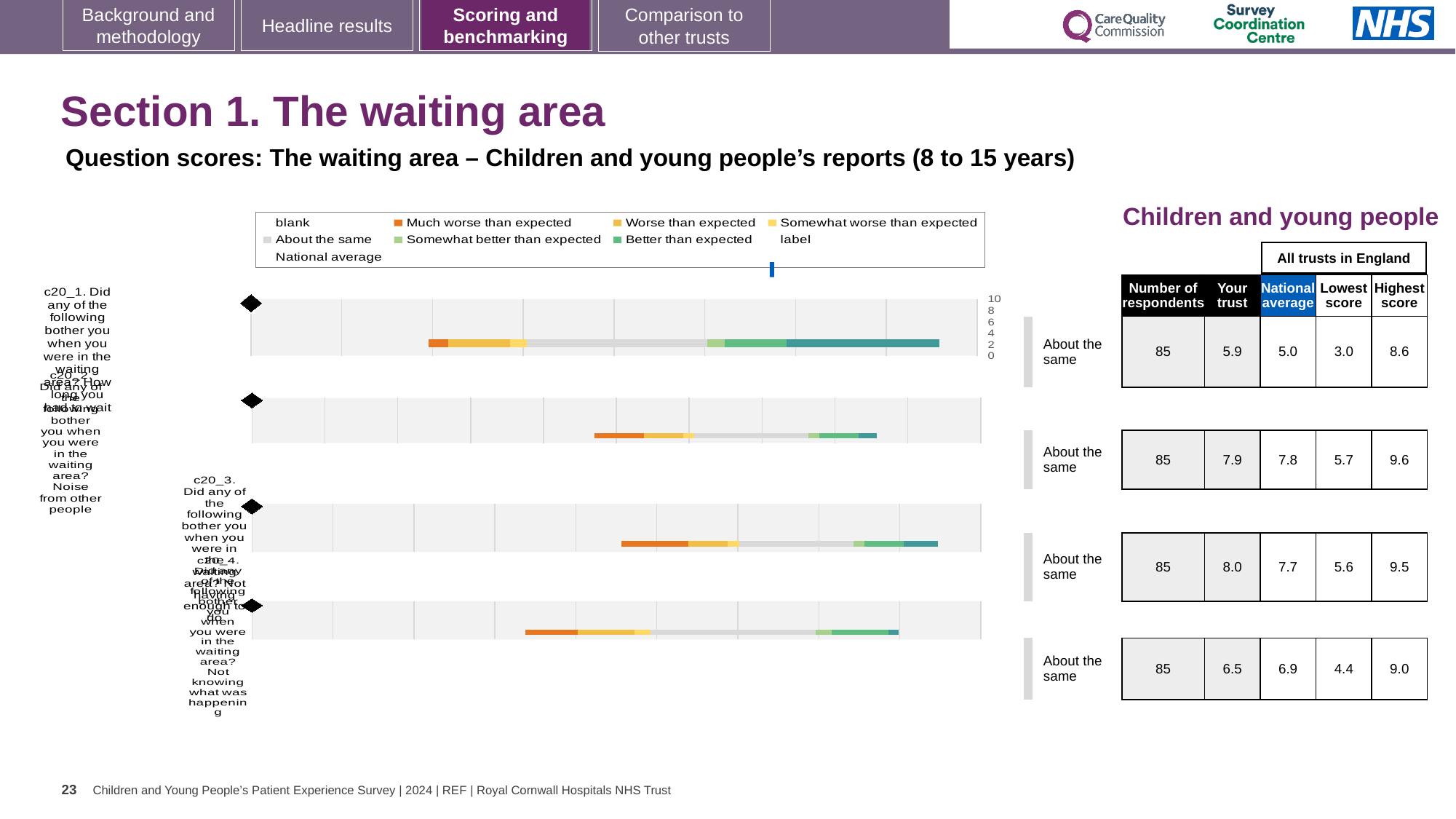
What is the national average score for c20_2 (Noise from other people)? 7.8 What is the highest score among all trusts in England for c20_3 (Not having enough to do)? 9.5 What is the difference between the highest score and the lowest score for c20_1 (How long you had to wait)? 5.6 What is the lowest score among all trusts in England for c20_4 (Not knowing what was happening)? 4.4 What is the 'Your trust' score for c20_1 (How long you had to wait)? 5.9 For c20_4 (Not knowing what was happening), which is larger: the 'Your trust' score or the national average? National average How many respondents are listed for each of the waiting area questions? 85 Which question has the lowest 'Your trust' score? c20_1 (How long you had to wait) What kind of chart is used to show the question scores for the waiting area? bar chart What benchmark category label is shown next to each of the four charts? About the same How many question charts are shown on the slide for the waiting area section? 4 Which question has the highest 'Your trust' score? c20_3 (Not having enough to do)